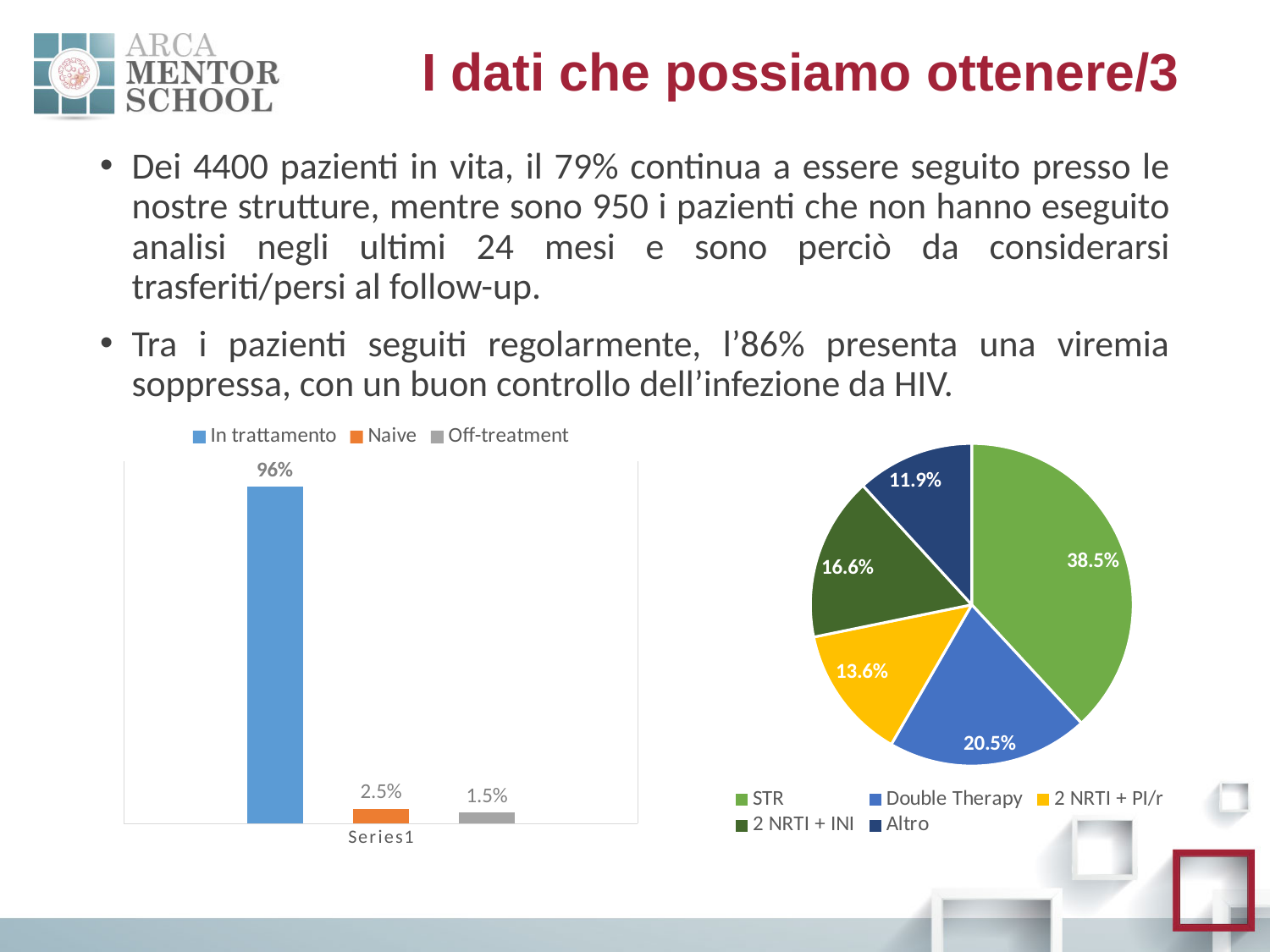
In the pie chart on the right, which category has the smallest slice? Altro In the bar chart on the left, how many series does the legend list? 3 In the bar chart on the left, what is the value for In trattamento? 96% In the bar chart on the left, what is the difference between the Naive and Off-treatment values? 1% In the pie chart on the right, which is larger: Double Therapy or 2 NRTI + PI/r? Double Therapy In the pie chart on the right, what is the difference between the STR and Double Therapy shares? 18% In the bar chart on the left, what is the value for Naive? 2.5% In the pie chart on the right, what share does 2 NRTI + INI have? 16.6% How many slices does the pie chart on the right have? 5 In the pie chart on the right, what share does STR have? 38.5% In the bar chart on the left, which series has the lowest value? Off-treatment What kind of chart is the chart on the left of the slide? Bar chart